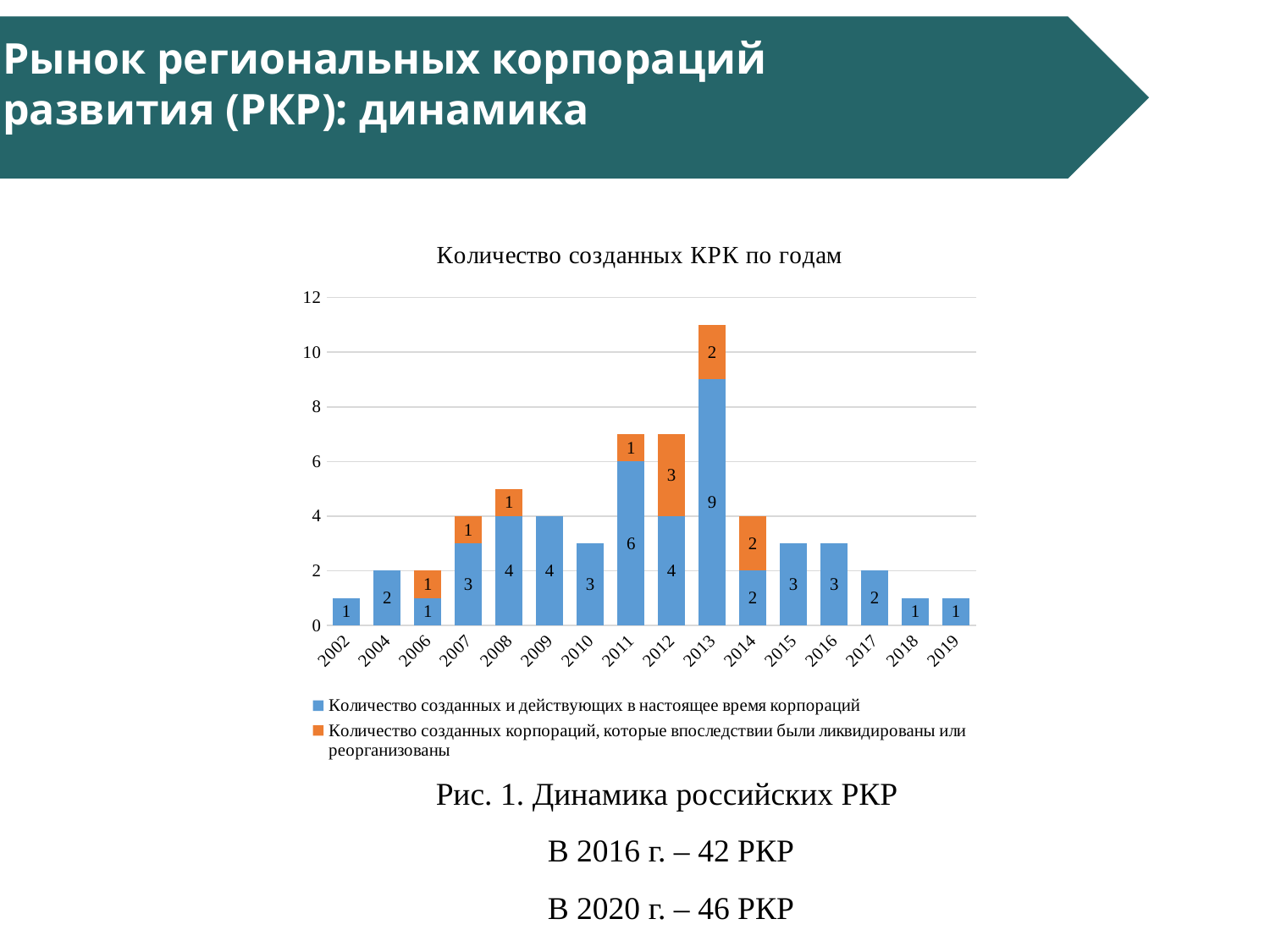
What is the difference between the 'Количество созданных и действующих в настоящее время корпораций' values for 2011 and 2010? 3 How many series does the legend list? 2 What is the total height of the stacked bar for 2013? 11 What is the total height of the stacked bar for 2012? 7 Is the total stacked value for 2013 greater or less than 10? greater Which year has the highest value for 'Количество созданных и действующих в настоящее время корпораций'? 2013 What is the value of 'Количество созданных корпораций, которые впоследствии были ликвидированы или реорганизованы' for 2012? 3 What type of chart is shown on the slide? Stacked bar chart How many years are shown on the x axis of the chart? 16 What is the value of 'Количество созданных и действующих в настоящее время корпораций' for 2013? 9 What is the title of the chart? Количество созданных КРК по годам Which is larger: the 'Количество созданных и действующих в настоящее время корпораций' value for 2011 or for 2012? 2011